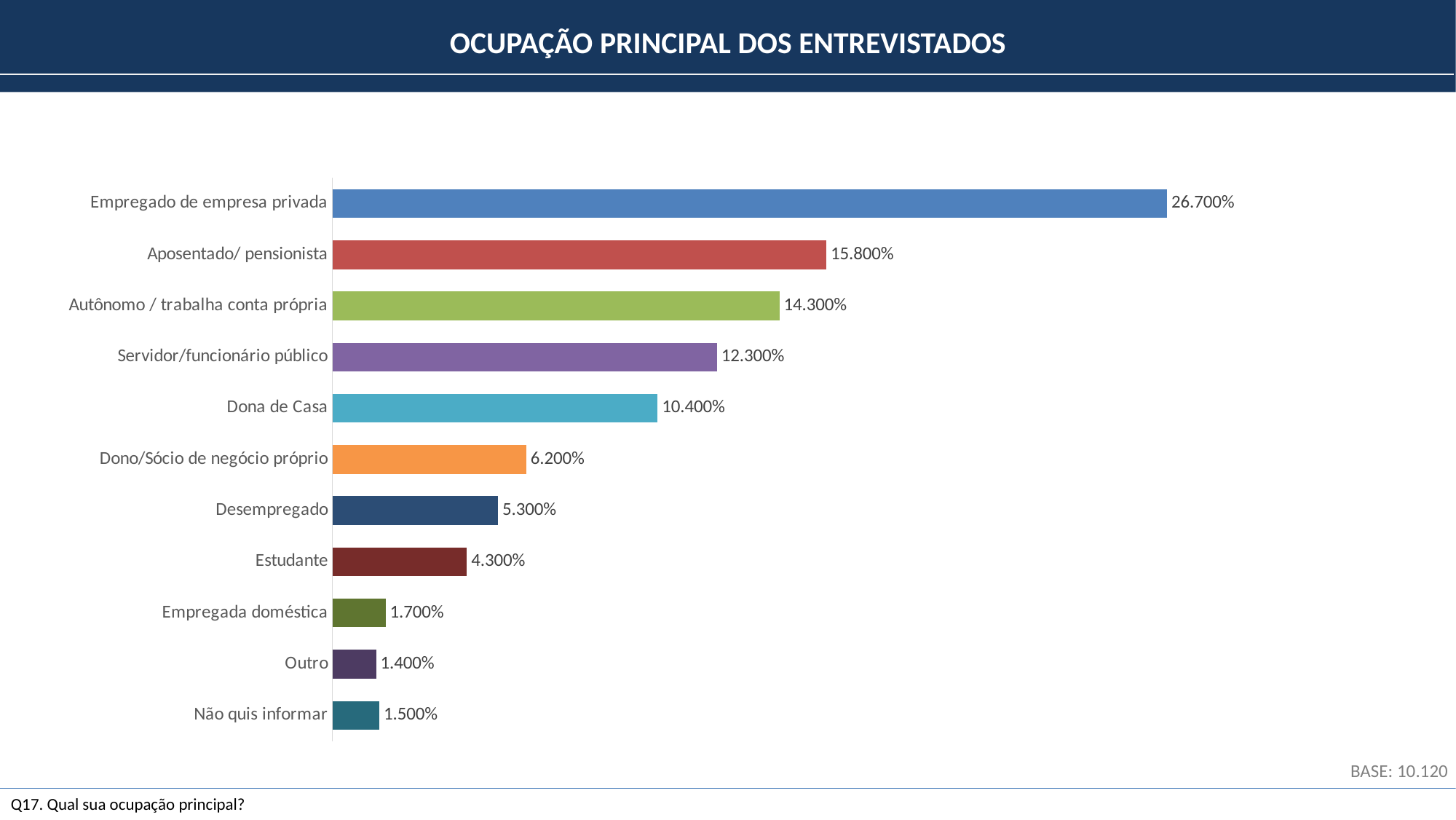
How many categories are shown in the chart? 11 Which category has the lowest value? Outro Which category has the highest value? Empregado de empresa privada What kind of chart is shown on the slide? Bar chart Which is larger, the value for Empregada doméstica or the value for Não quis informar? Empregada doméstica What is the value for Dona de Casa? 10.400% What is the value for Estudante? 4.300% What is the title of the slide? OCUPAÇÃO PRINCIPAL DOS ENTREVISTADOS What is the difference between Empregado de empresa privada and Servidor/funcionário público? 14.400% What is the difference between Aposentado/ pensionista and Autônomo / trabalha conta própria? 1.500% What is the value for Empregado de empresa privada? 26.700%